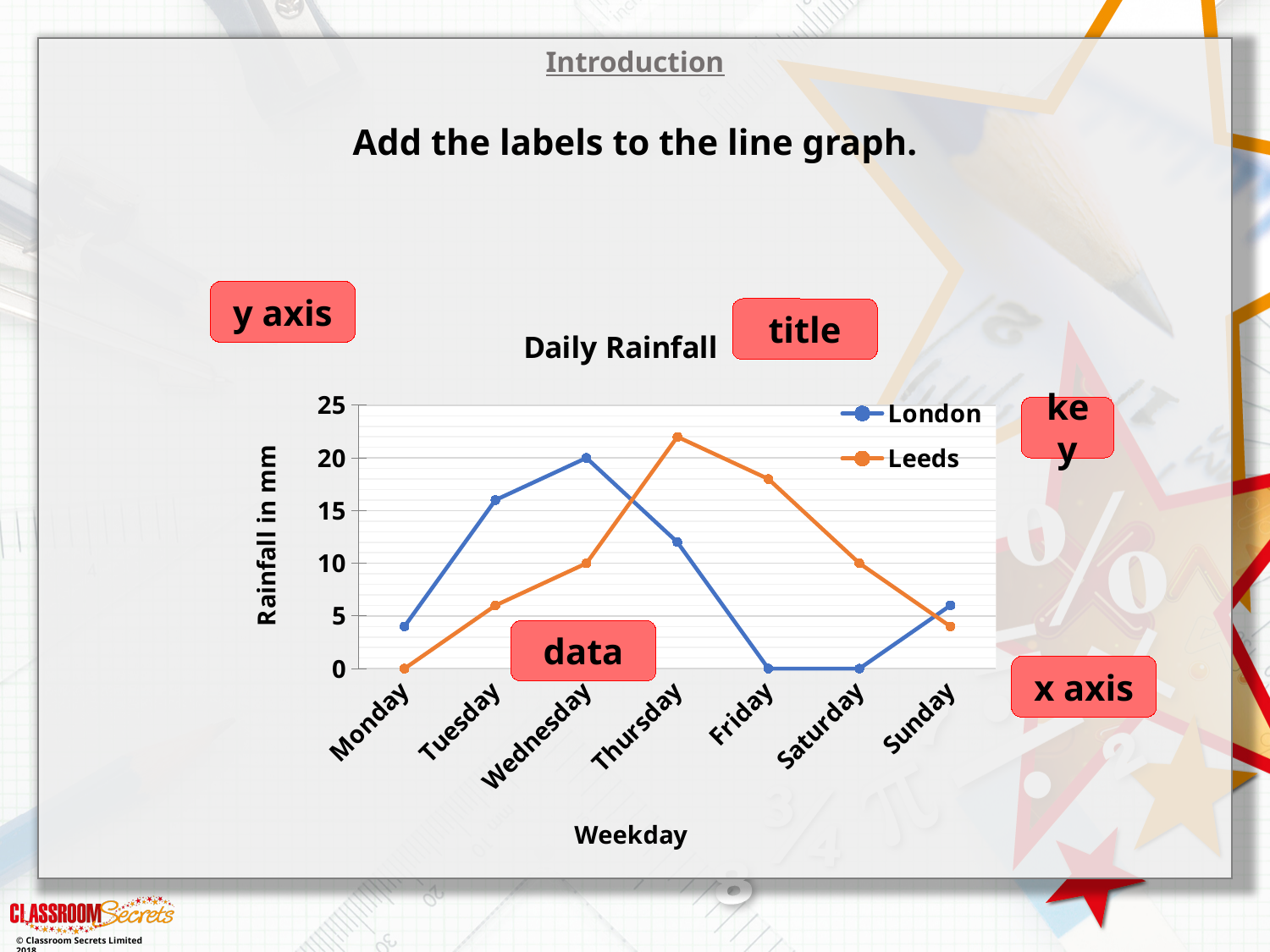
How many series does the legend list? 2 Is the rainfall for Leeds on Friday greater or less than 15? greater What is the rainfall in mm for London on Wednesday? 20 What type of chart is shown on the slide? line chart What is the difference in rainfall in mm between London and Leeds on Wednesday? 10 On which day is the rainfall for Leeds lowest? Monday How many weekdays are plotted along the x axis? 7 What is the title of the chart? Daily Rainfall What is the rainfall in mm for Leeds on Saturday? 10 On Thursday, which has more rainfall, London or Leeds? Leeds On which day is the rainfall for Leeds highest? Thursday On which day is the rainfall for London highest? Wednesday